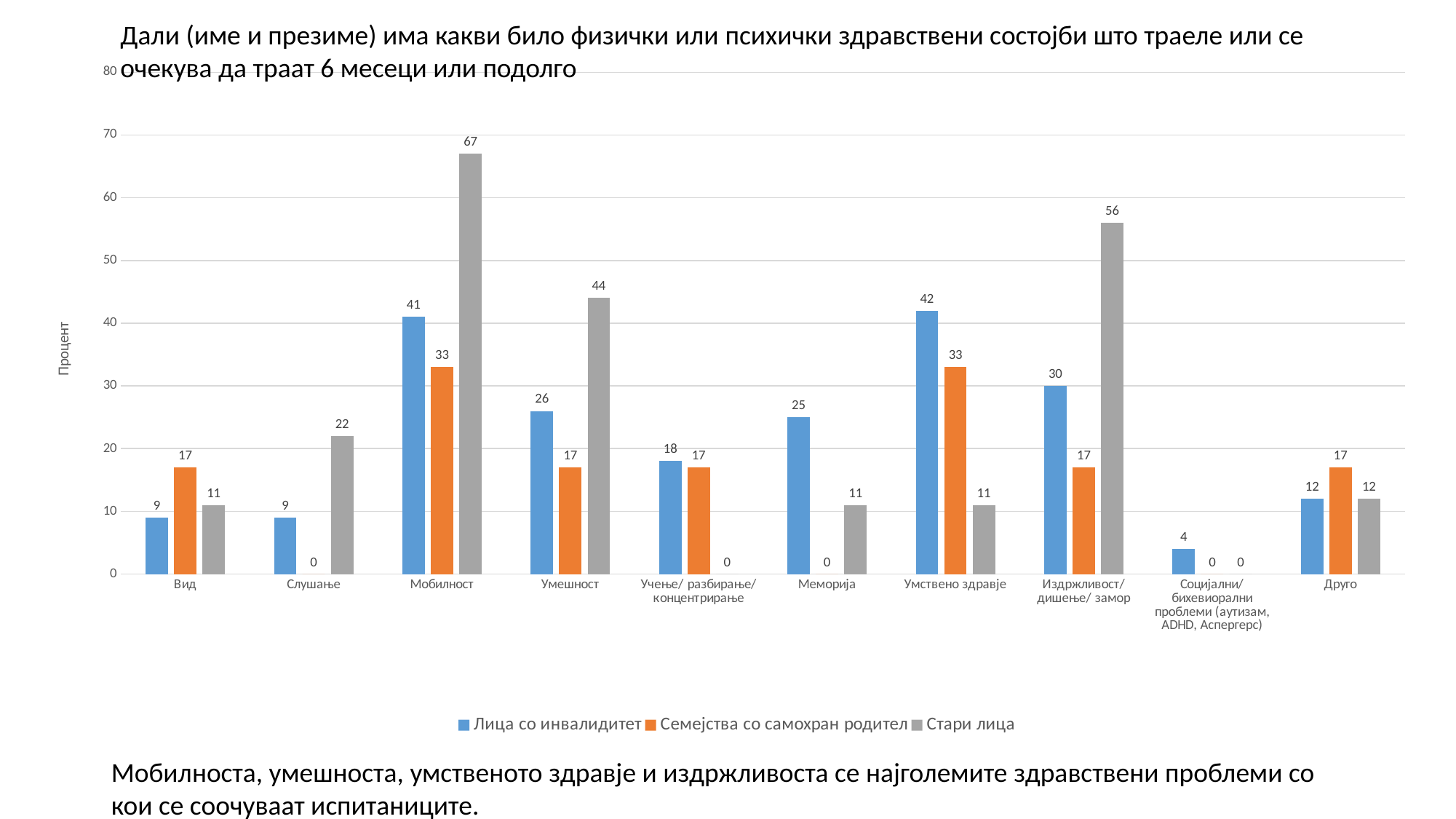
In the Умешност category, which is larger: Лица со инвалидитет or Стари лица? Стари лица What is the difference between Стари лица and Лица со инвалидитет in the Мобилност category? 26 What is the value for Лица со инвалидитет in the Умствено здравје category? 42 How many series does the legend list? 3 In which category does Стари лица have its highest value? Мобилност What is the label of the y axis? Процент What is the value for Семејства со самохран родител in the Издржливост/ дишење/ замор category? 17 In which category does Лица со инвалидитет have its lowest value? Социјални/ бихевиорални проблеми (аутизам, ADHD, Аспергерс) What kind of chart is shown on the slide? bar chart How many categories are shown on the x axis? 10 Which series is shown in orange in the legend? Семејства со самохран родител What is the value for Стари лица in the Мобилност category? 67